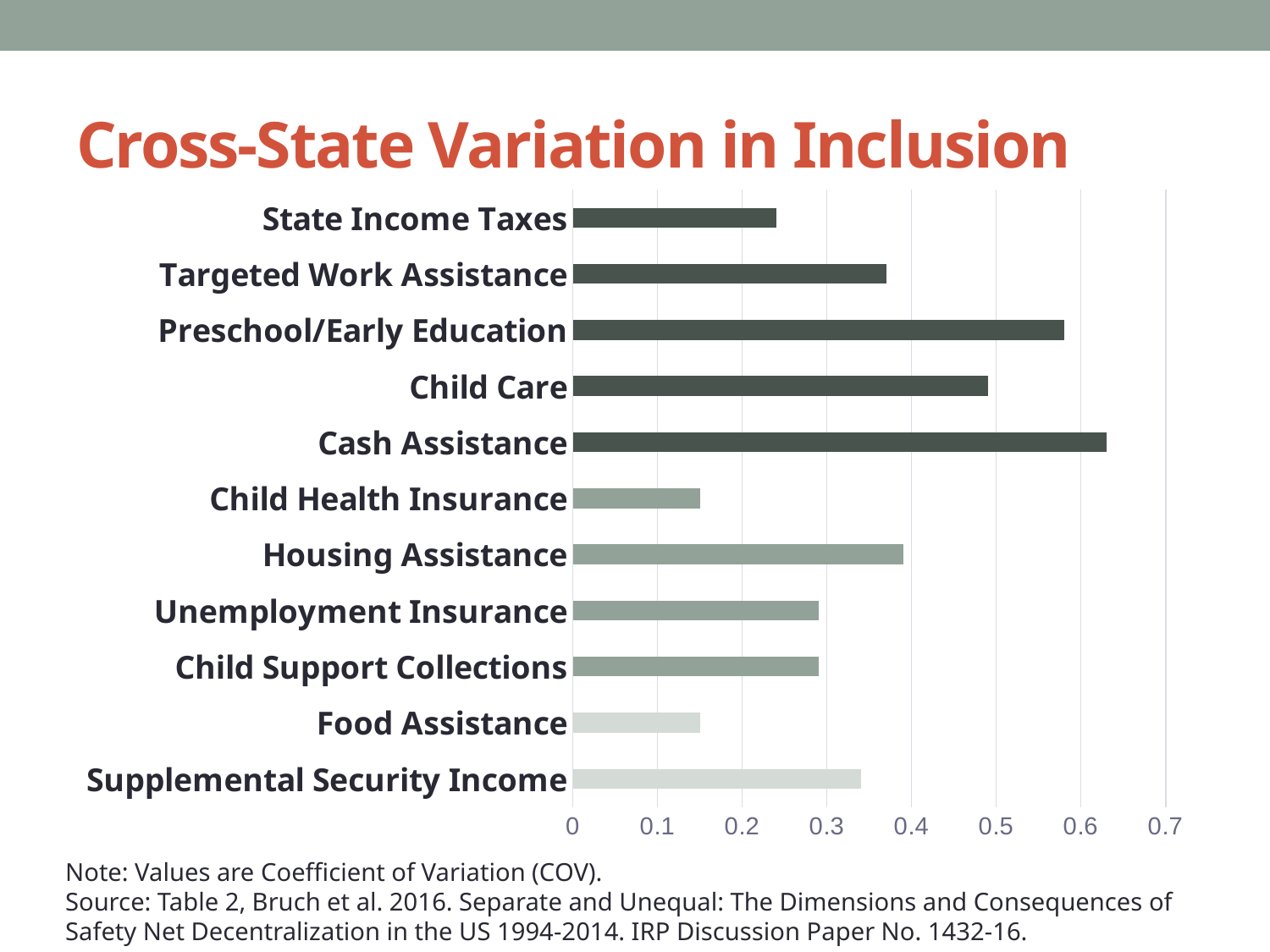
What kind of chart is shown on the slide? bar chart Is the value for Targeted Work Assistance greater or less than 0.4? less What is the title of the chart on the slide? Cross-State Variation in Inclusion Which category has the highest value in the chart? Cash Assistance How many categories are plotted in the chart? 11 Is the value for Supplemental Security Income greater or less than 0.3? greater Is the value for Preschool/Early Education greater or less than 0.5? greater Which has a larger value, Housing Assistance or Unemployment Insurance? Housing Assistance Which has a larger value, Preschool/Early Education or Child Care? Preschool/Early Education